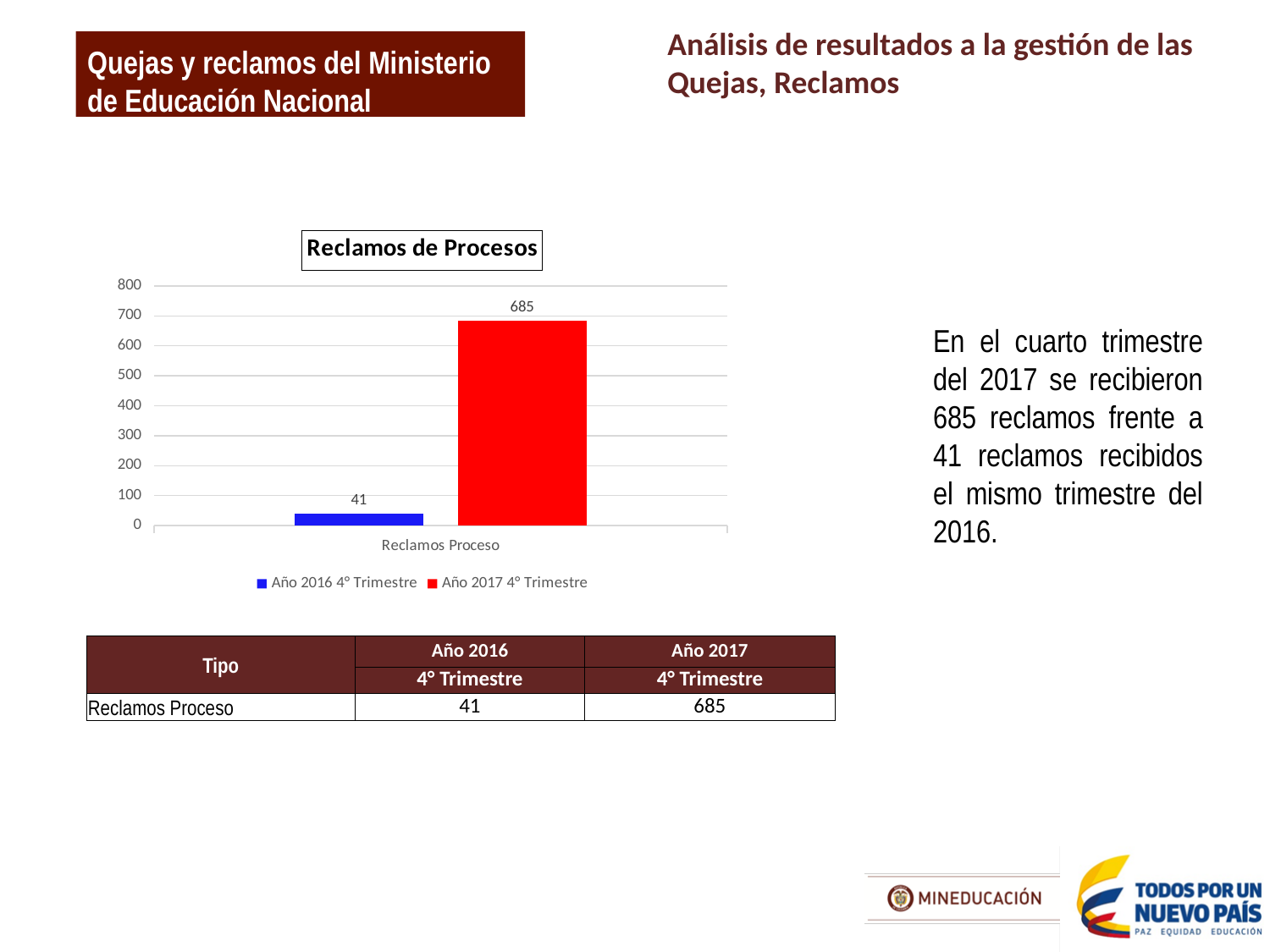
Is the value for Año 2016 4° Trimestre greater or less than 100? less What is the value for Año 2016 4° Trimestre in the Reclamos de Procesos chart? 41 What is the difference between the Año 2017 4° Trimestre and Año 2016 4° Trimestre values in the Reclamos de Procesos chart? 644 Which series has the higher value in the Reclamos de Procesos chart? Año 2017 4° Trimestre Is the value for Año 2017 4° Trimestre greater or less than 600? greater What colour is the bar for Año 2017 4° Trimestre in the Reclamos de Procesos chart? red How many series does the legend of the Reclamos de Procesos chart list? 2 Which series has the lower value in the Reclamos de Procesos chart? Año 2016 4° Trimestre What is the value for Año 2017 4° Trimestre in the Reclamos de Procesos chart? 685 Is the value for Año 2017 4° Trimestre larger or smaller than the value for Año 2016 4° Trimestre? larger What is the title of the chart on the slide? Reclamos de Procesos What kind of chart is the Reclamos de Procesos chart? bar chart